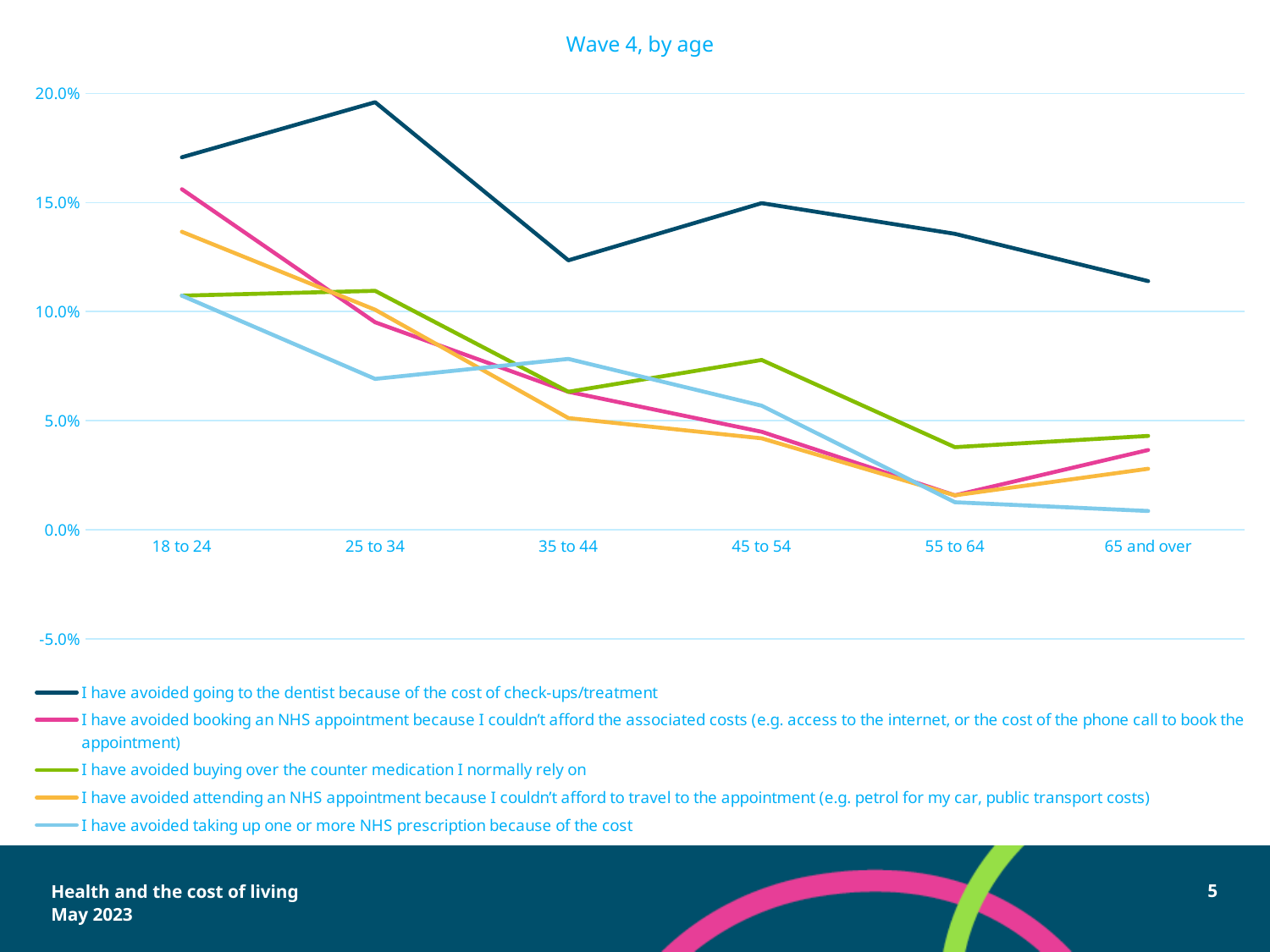
How many series does the legend list? 5 Is the value for 'I have avoided taking up one or more NHS prescription because of the cost' for 65 and over greater or less than 5.0%? less For 65 and over, which is larger: the value for avoiding buying over the counter medication or the value for avoiding taking up one or more NHS prescription? avoiding buying over the counter medication How many age groups are shown on the x axis? 6 Is the value for 'I have avoided going to the dentist because of the cost of check-ups/treatment' for 25 to 34 greater or less than 15.0%? greater For 18 to 24, which is larger: the value for avoiding going to the dentist or the value for avoiding booking an NHS appointment? avoiding going to the dentist What is the title of the chart? Wave 4, by age Is the value for 'I have avoided going to the dentist because of the cost of check-ups/treatment' for 35 to 44 greater or less than 15.0%? less What kind of chart is shown on the slide? line chart For which age group is the value for 'I have avoided going to the dentist because of the cost of check-ups/treatment' lowest? 65 and over Does the line for 'I have avoided taking up one or more NHS prescription because of the cost' rise or fall from 45 to 54 to 65 and over? fall For which age group is the value for 'I have avoided going to the dentist because of the cost of check-ups/treatment' highest? 25 to 34